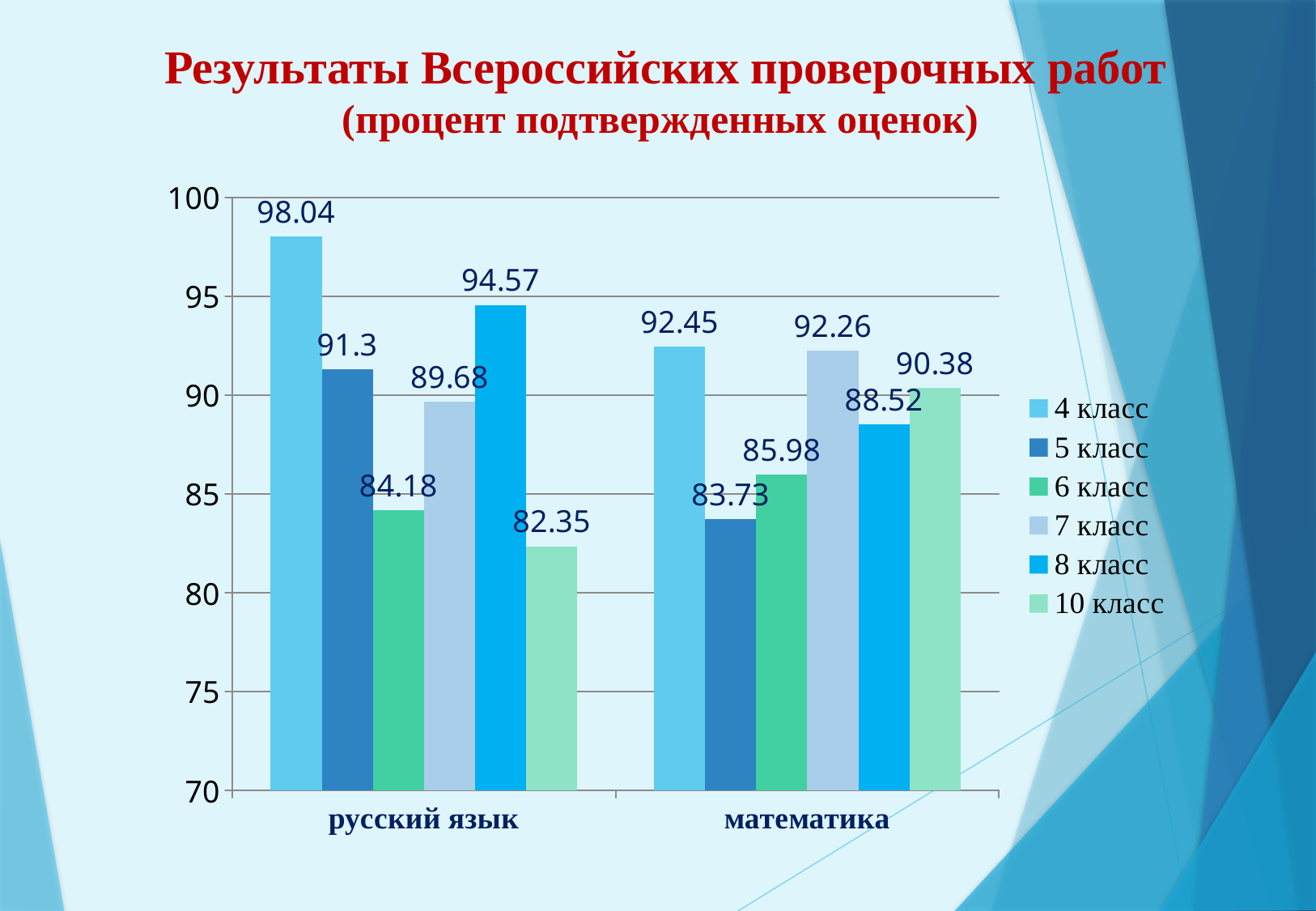
What is the difference between the 4 класс values for русский язык and математика? 5.59 What is the value for 5 класс in математика? 83.73 Which class has the highest value in русский язык? 4 класс Which class has the lowest value in математика? 5 класс Is the value for 8 класс in русский язык greater or less than 90? greater What kind of chart is shown on the slide? bar chart Which is larger for 6 класс: русский язык or математика? математика What is the value for 10 класс in математика? 90.38 What is the value for 4 класс in русский язык? 98.04 How many series does the legend list? 6 Which class has the lowest value in русский язык? 10 класс How many categories are shown on the x axis? 2